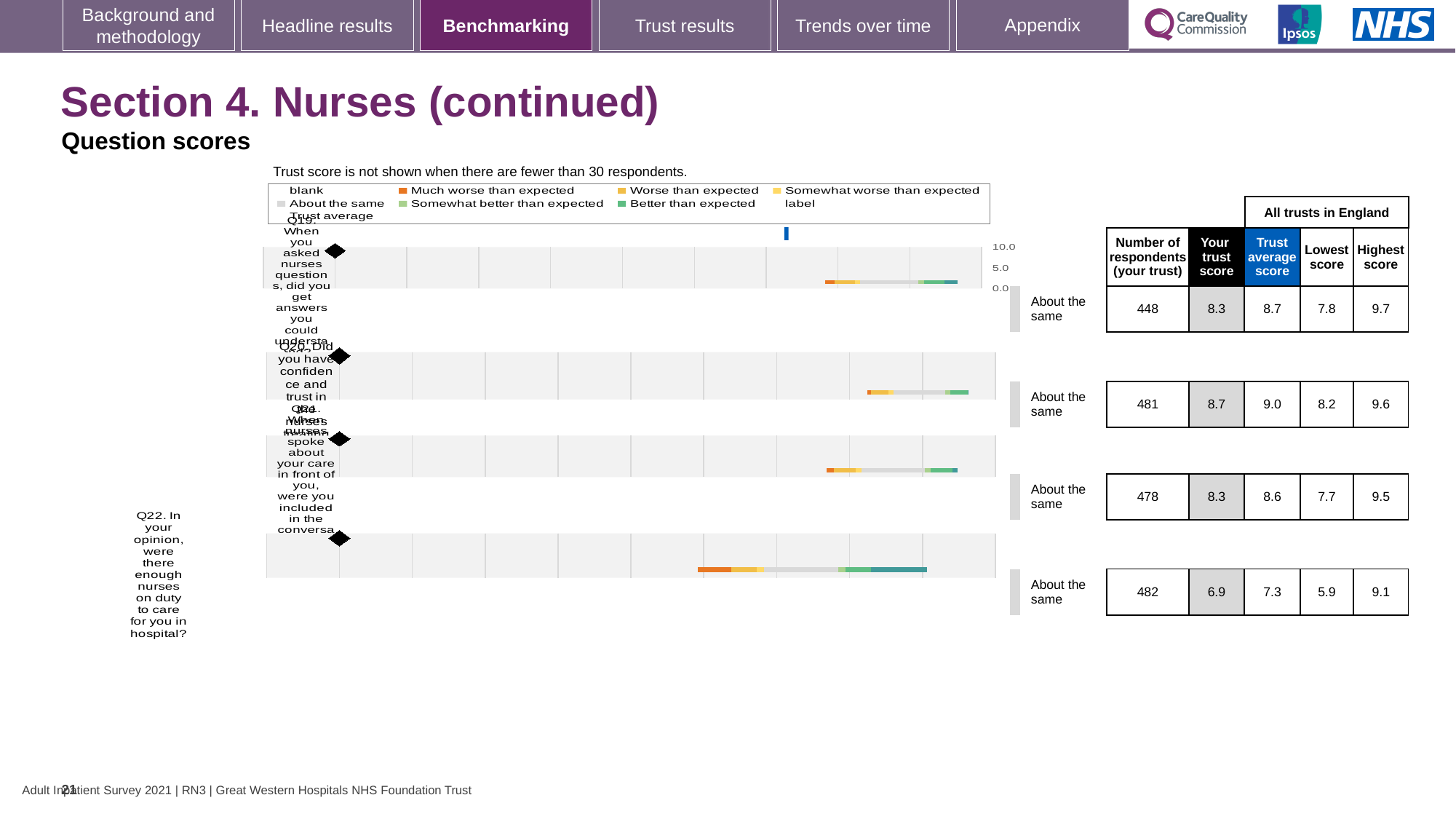
What is the lowest score across all trusts in England for Q21? 7.7 Which question has the highest trust average score? Q20 Is your trust score for Q19 higher or lower than the trust average score? lower What is the difference between the trust average score and your trust score for Q22? 0.4 What is the difference between the highest and lowest scores in England for Q20? 1.4 Which question has the lowest 'Your trust score'? Q22 What is the highest score across all trusts in England for Q22? 9.1 How many respondents did the trust have for Q22 (enough nurses on duty)? 482 What is the trust's score for Q20 (confidence and trust in nurses)? 8.7 What is the trust average score for Q19 (answers you could understand)? 8.7 How many questions are shown in the chart? 4 What benchmark category label is shown for every question on this slide? About the same